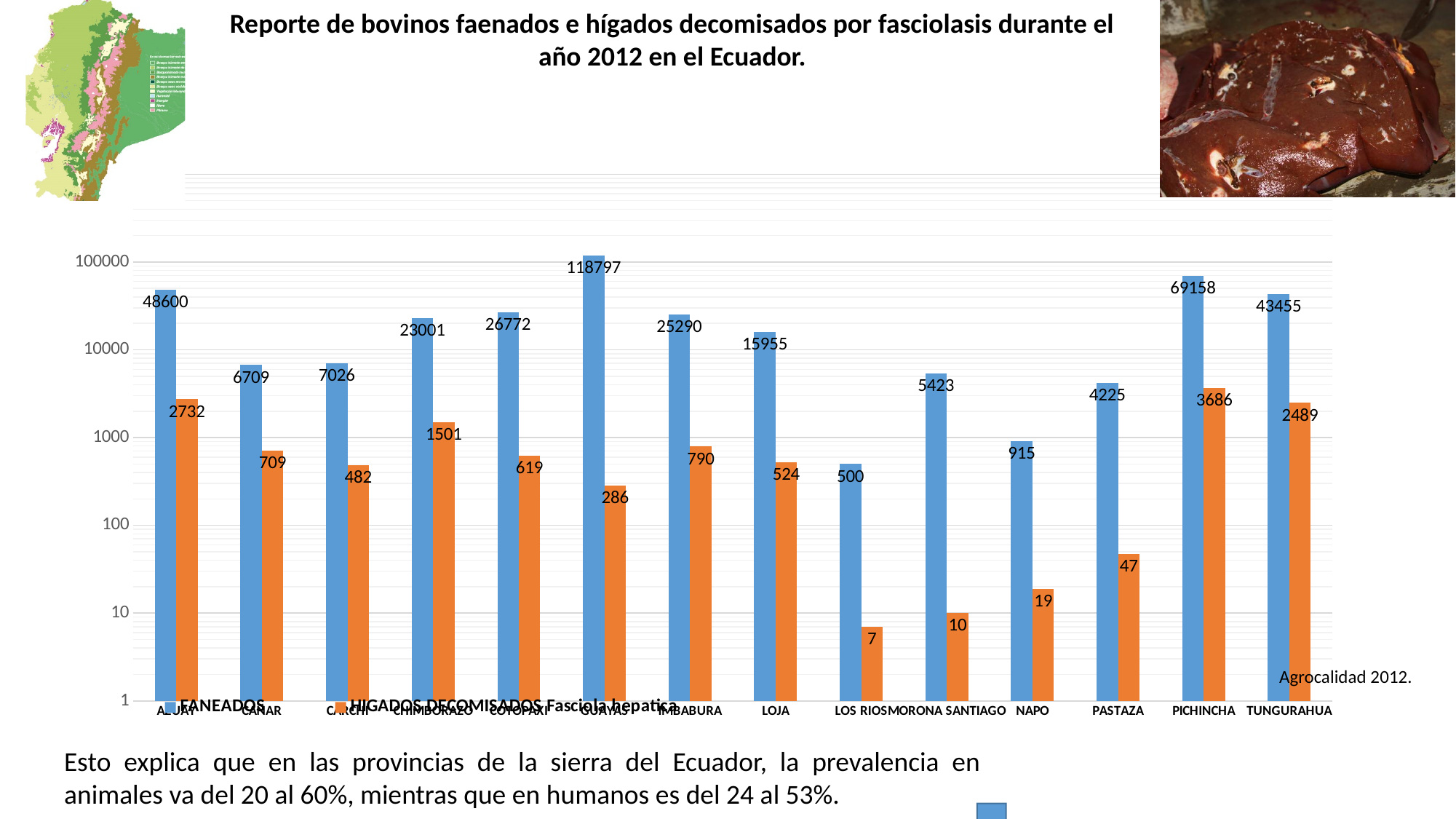
What is the FAENADOS value for NAPO? 915 Which is larger, the HIGADOS DECOMISADOS value for AZUAY or for PICHINCHA? PICHINCHA What is the FAENADOS value for PICHINCHA? 69158 What is the difference between the HIGADOS DECOMISADOS values for CHIMBORAZO and COTOPAXI? 882 What is the difference between the FAENADOS values for PICHINCHA and TUNGURAHUA? 25703 What is the HIGADOS DECOMISADOS value for LOS RIOS? 7 How many series does the chart legend list? 2 What type of chart is shown on the slide? bar chart What colour are the FAENADOS bars in the chart? blue Which province has the lowest HIGADOS DECOMISADOS value? LOS RIOS Which province has the highest FAENADOS value? GUAYAS How many provinces (categories) are shown on the x axis of the chart? 14